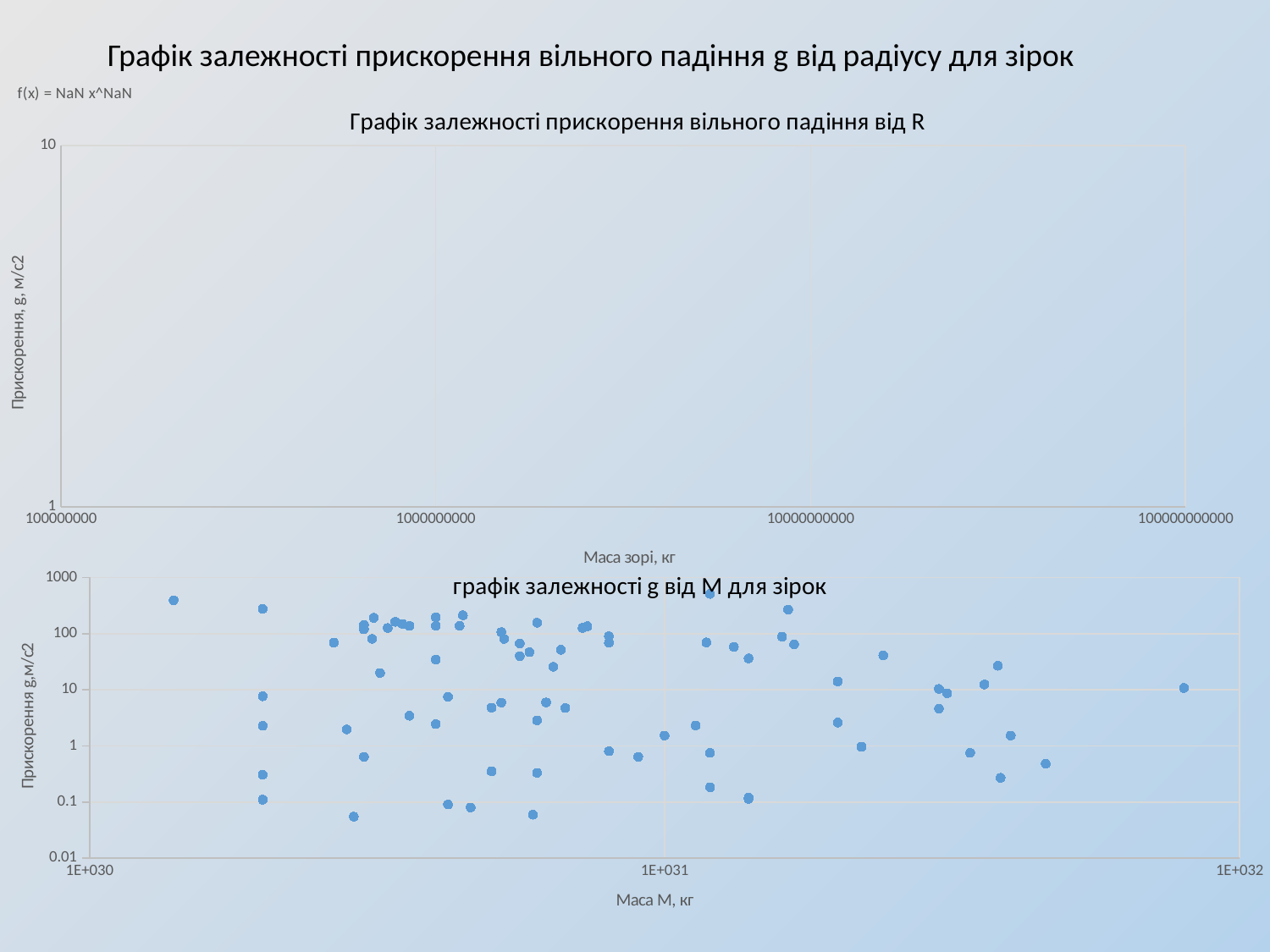
In the bottom chart "графік залежності g від M для зірок", is the highest plotted point greater or less than 100? greater In the bottom chart "графік залежності g від M для зірок", is the leftmost plotted point (near 1E+030) greater or less than 100? greater In the bottom chart "графік залежності g від M для зірок", is the lowest plotted point greater or less than 0.1? less What is the x-axis label of the bottom chart "графік залежності g від M для зірок"? Маса M, кг What is the title of the bottom chart on the slide? графік залежності g від M для зірок What kind of chart is the bottom chart titled "графік залежності g від M для зірок"? scatter chart